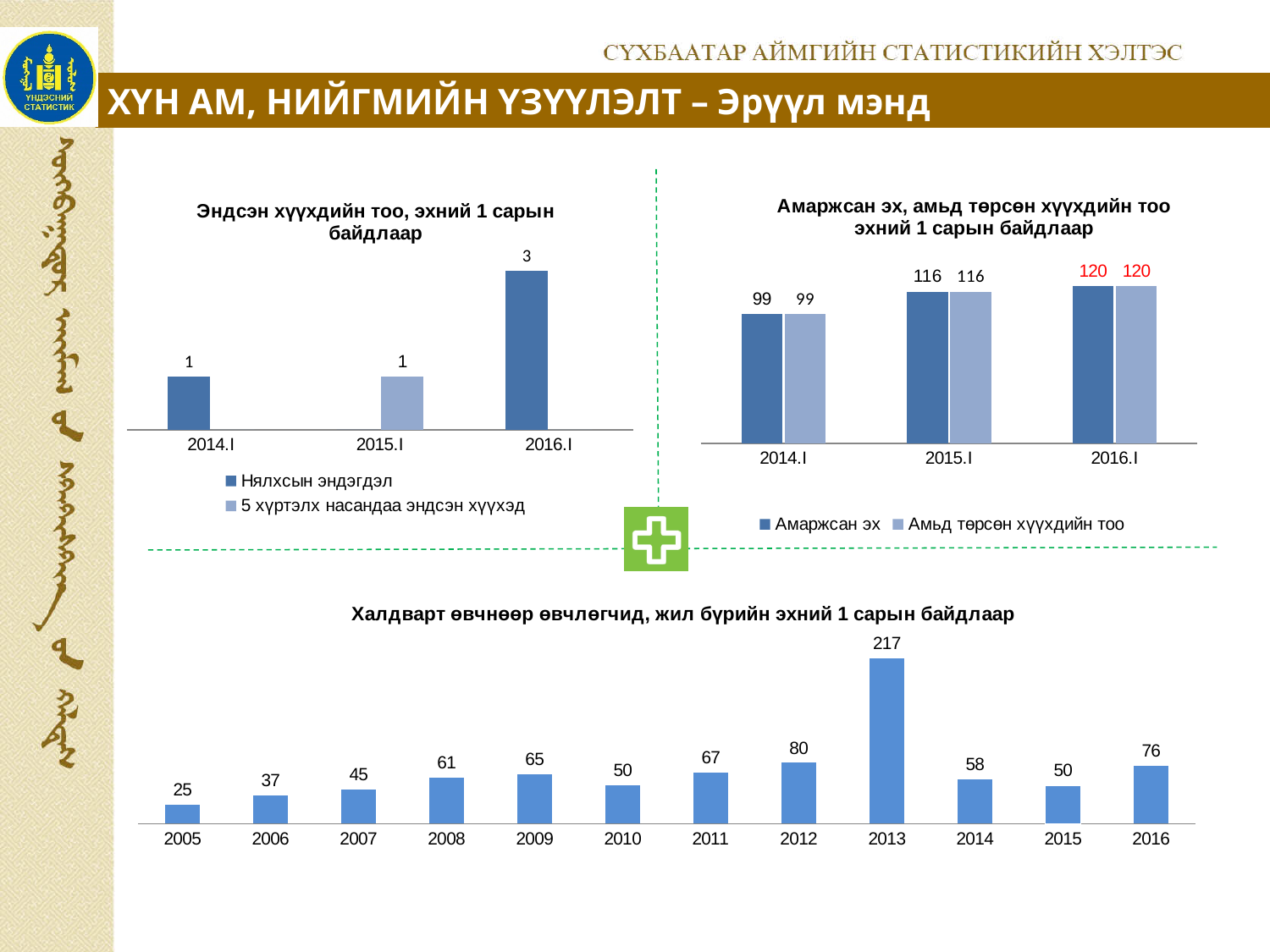
In the bottom chart (Халдварт өвчнөөр өвчлөгчид), how many years are shown on the x axis? 12 What kind of chart is the top-left chart (Эндсэн хүүхдийн тоо)? bar chart In the bottom chart (Халдварт өвчнөөр өвчлөгчид), what is the difference between the values for 2012 and 2011? 13 In the bottom chart (Халдварт өвчнөөр өвчлөгчид), which year has the highest value? 2013 In the top-right chart (Амаржсан эх, амьд төрсөн хүүхдийн тоо), what is the difference between the Амьд төрсөн хүүхдийн тоо values for 2016.I and 2014.I? 21 In the top-right chart (Амаржсан эх, амьд төрсөн хүүхдийн тоо), what is the value of Амаржсан эх for 2015.I? 116 In the top-left chart (Эндсэн хүүхдийн тоо), what is the value of Нялхсын эндэгдэл for 2016.I? 3 In the top-right chart (Амаржсан эх, амьд төрсөн хүүхдийн тоо), how many series does the legend list? 2 In the bottom chart (Халдварт өвчнөөр өвчлөгчид), which is larger, the value for 2016 or the value for 2014? 2016 In the bottom chart (Халдварт өвчнөөр өвчлөгчид), what is the value for 2013? 217 In the top-right chart (Амаржсан эх, амьд төрсөн хүүхдийн тоо), do the values rise or fall from 2014.I to 2016.I? rise In the bottom chart (Халдварт өвчнөөр өвчлөгчид), which year has the lowest value? 2005